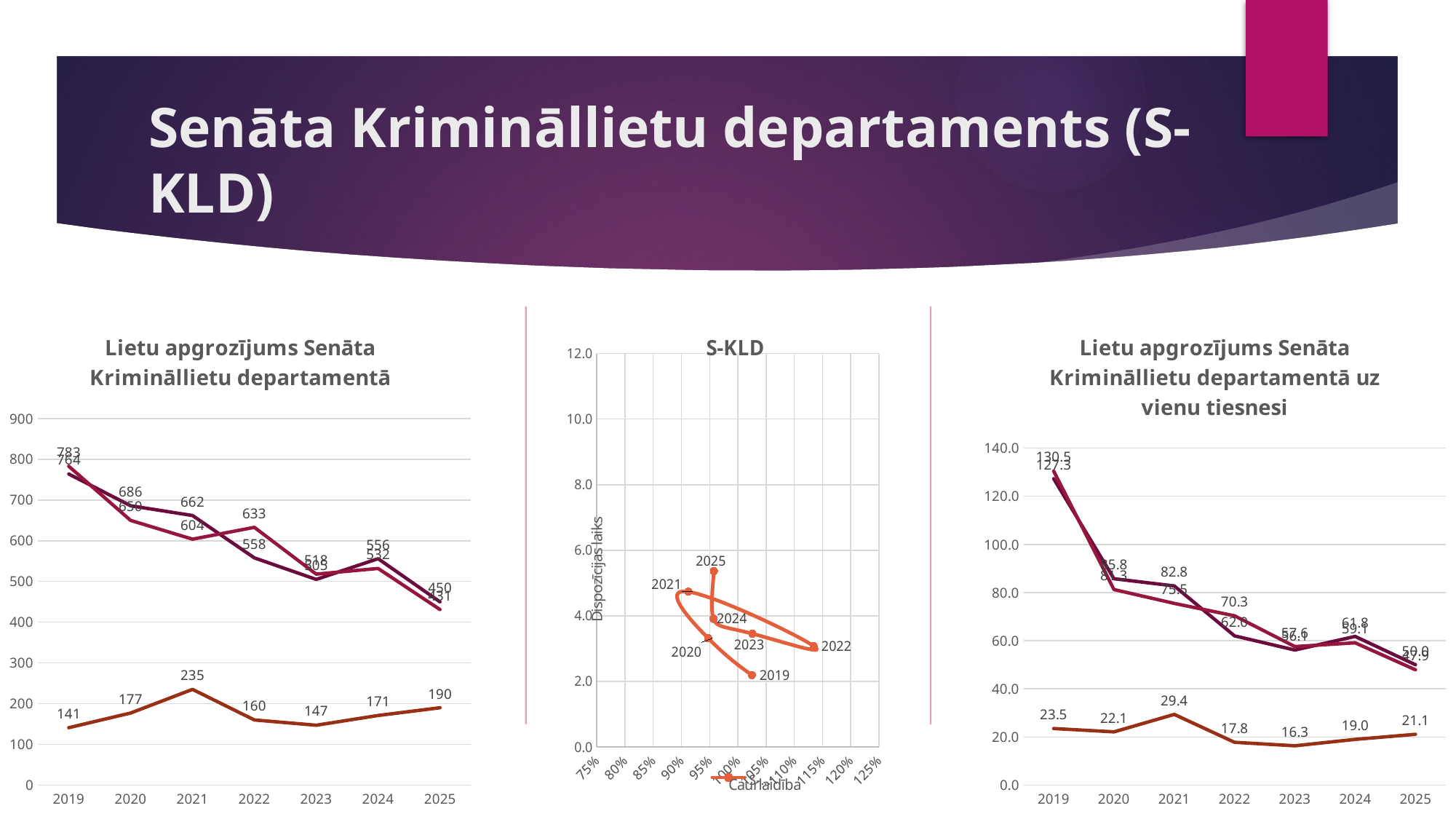
In the chart 'Lietu apgrozījums Senāta Krimināllietu departamentā uz vienu tiesnesi', what is the difference between the bottom line's 2021 value and its 2023 value? 13.1 What kind of chart is 'Lietu apgrozījums Senāta Krimināllietu departamentā'? Line chart In the chart 'S-KLD', is the Dispozīcijas laiks value for the 2019 point greater or less than 4.0? less In the chart 'Lietu apgrozījums Senāta Krimināllietu departamentā', what is the difference between the bottom line's 2021 value and its 2019 value? 94 How many years are shown on the x axis of the chart 'Lietu apgrozījums Senāta Krimināllietu departamentā'? 7 In the chart 'Lietu apgrozījums Senāta Krimināllietu departamentā', in which year does the bottom line reach its highest value? 2021 In the chart 'Lietu apgrozījums Senāta Krimināllietu departamentā uz vienu tiesnesi', what is the value of the bottom line in 2021? 29.4 In the chart 'Lietu apgrozījums Senāta Krimināllietu departamentā', in which year is the bottom line at its lowest value? 2019 What is the label of the horizontal axis in the chart 'S-KLD'? Caurlaidība In the chart 'Lietu apgrozījums Senāta Krimināllietu departamentā uz vienu tiesnesi', in which year is the bottom line at its lowest value? 2023 In the chart 'Lietu apgrozījums Senāta Krimināllietu departamentā', does the top line generally rise or fall from 2019 to 2025? Fall In the chart 'Lietu apgrozījums Senāta Krimināllietu departamentā', what is the value of the bottom line in 2021? 235